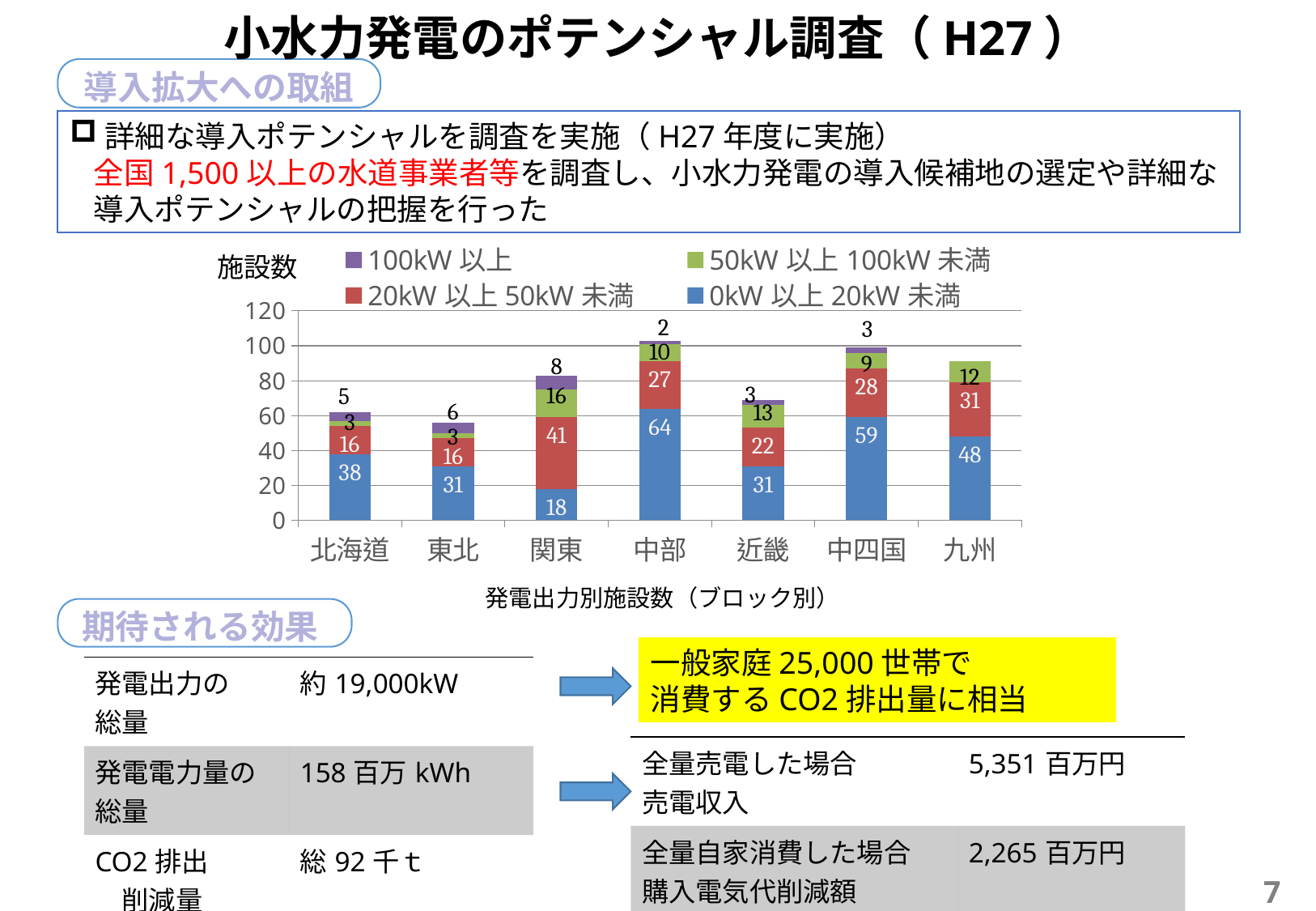
In the chart 発電出力別施設数（ブロック別）, which block has the highest value for the 0kW以上20kW未満 series? 中部 In the chart 発電出力別施設数（ブロック別）, what is the value of the 0kW以上20kW未満 series for 中部? 64 In the chart 発電出力別施設数（ブロック別）, what is the total number of facilities for 北海道 across all four series? 62 In the chart 発電出力別施設数（ブロック別）, what is the difference between the 0kW以上20kW未満 values for 中四国 and 北海道? 21 In the chart 発電出力別施設数（ブロック別）, what is the value of the 20kW以上50kW未満 series for 関東? 41 In the chart 発電出力別施設数（ブロック別）, what is the value of the 100kW以上 series for 関東? 8 How many series does the legend of the chart 発電出力別施設数（ブロック別） list? 4 In the chart 発電出力別施設数（ブロック別）, which block has the lowest value for the 0kW以上20kW未満 series? 関東 In the chart 発電出力別施設数（ブロック別）, which has the larger 20kW以上50kW未満 value, 関東 or 九州? 関東 What kind of chart is 発電出力別施設数（ブロック別）? stacked bar chart How many blocks (categories) are shown on the x axis of the chart 発電出力別施設数（ブロック別）? 7 In the chart 発電出力別施設数（ブロック別）, is the total height of the 東北 bar greater or less than 60? less